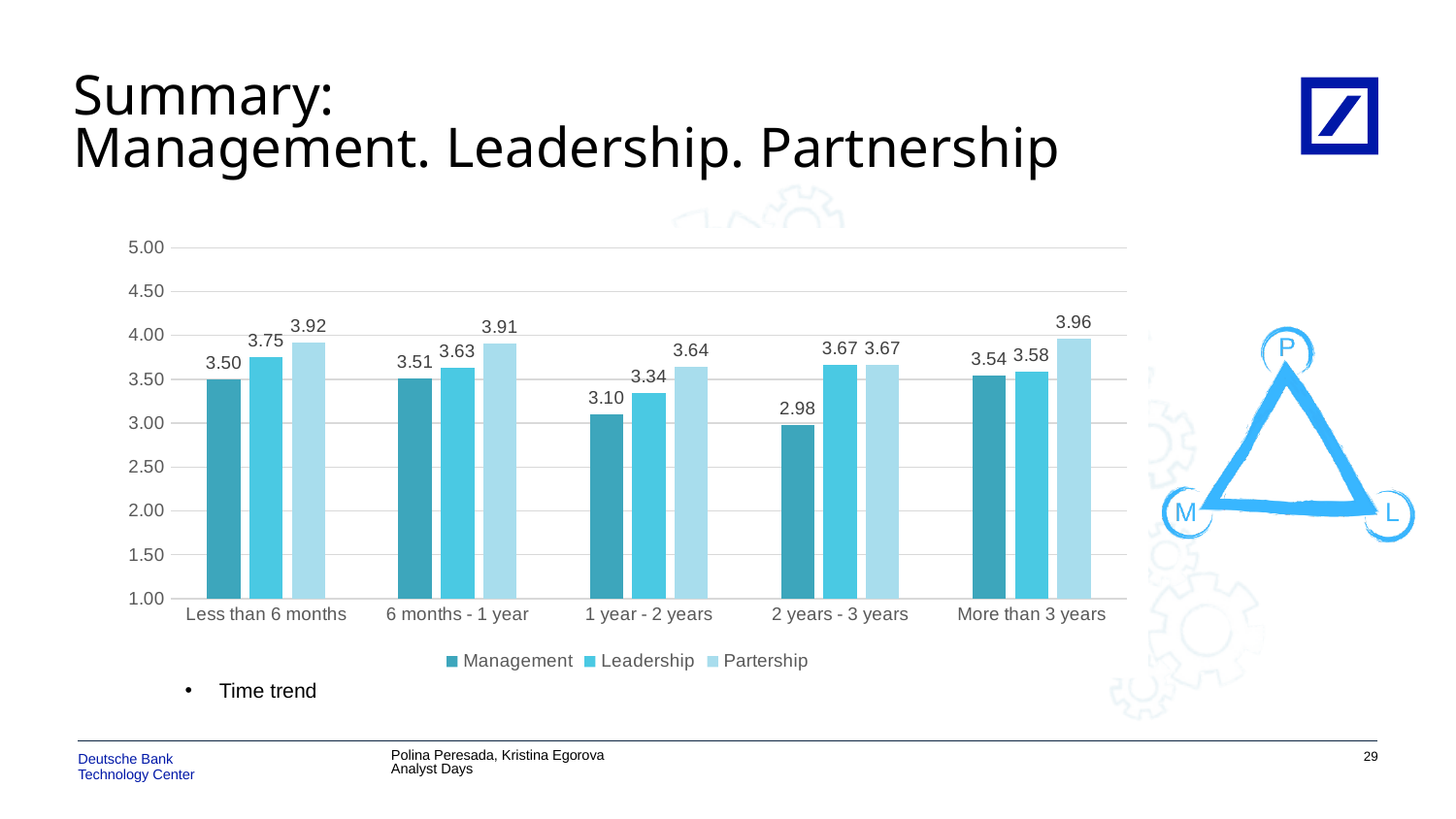
Which is larger for '6 months - 1 year': the Leadership value or the Partership value? Partership What is the Partership value for the 'More than 3 years' category? 3.96 What is the Leadership value for the '1 year - 2 years' category? 3.34 Which category has the highest Partership value? More than 3 years What are the three series listed in the legend? Management, Leadership, Partership How many categories are shown on the x axis? 5 What is the difference between the Partership and Management values for 'Less than 6 months'? 0.42 How many series does the legend list? 3 Is the Management value for '1 year - 2 years' greater or less than 3.50? less What kind of chart is shown on the slide? bar chart What is the Management value for the '2 years - 3 years' category? 2.98 Which category has the lowest Management value? 2 years - 3 years